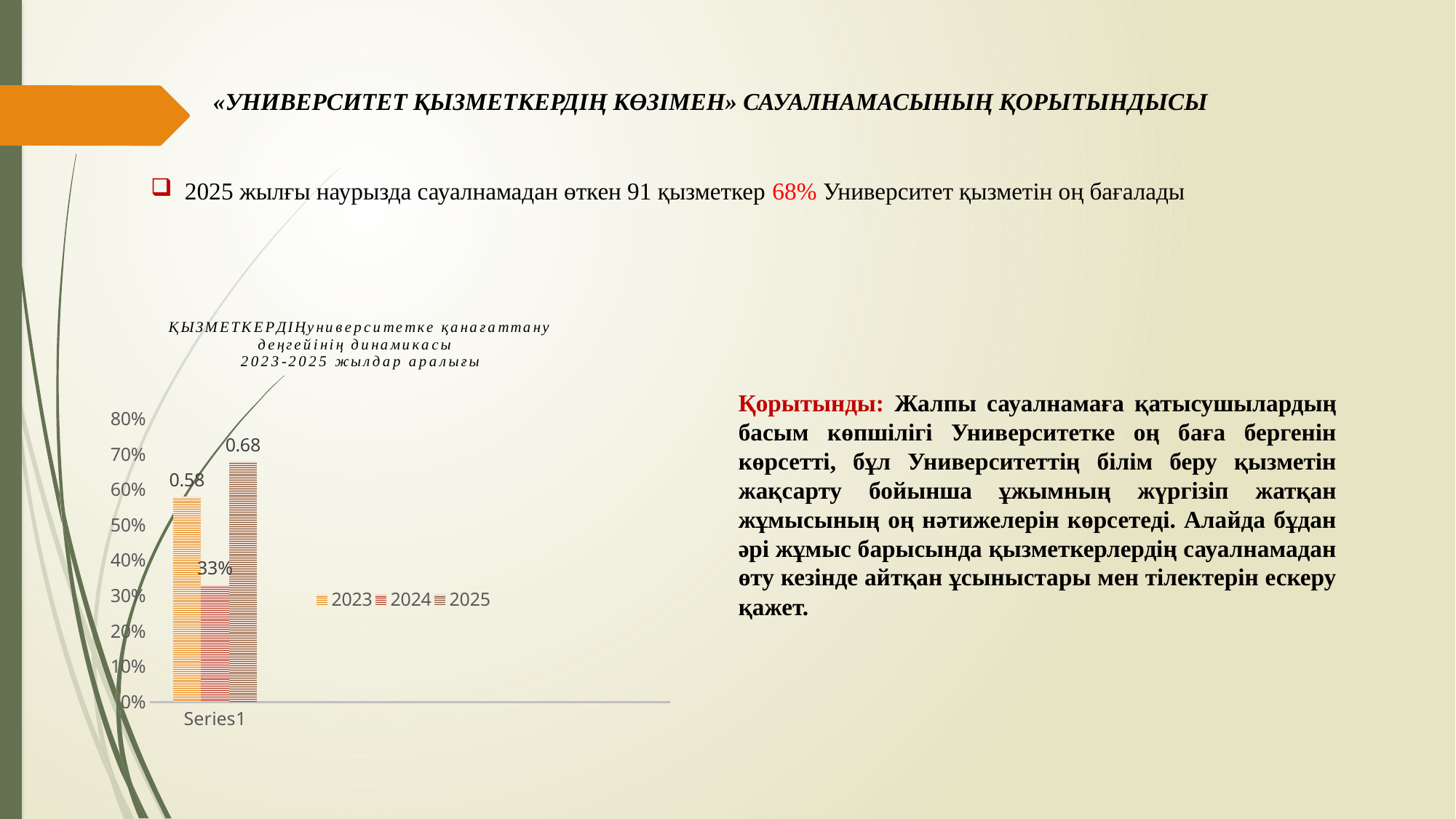
What is the data label shown for the 2024 series? 33% Which is larger, the value for 2023 or the value for 2025? 2025 Is the value for 2025 greater or less than 60%? greater What is the category label shown on the x axis of the chart? Series1 Is the value for 2024 greater or less than 40%? less What is the data label shown for the 2023 series? 0.58 What kind of chart is shown on the slide? bar chart What is the data label shown for the 2025 series? 0.68 Which series has the lowest bar? 2024 What is the highest value shown on the chart's y axis? 80% How many series does the legend list? 3 Which series has the highest bar? 2025